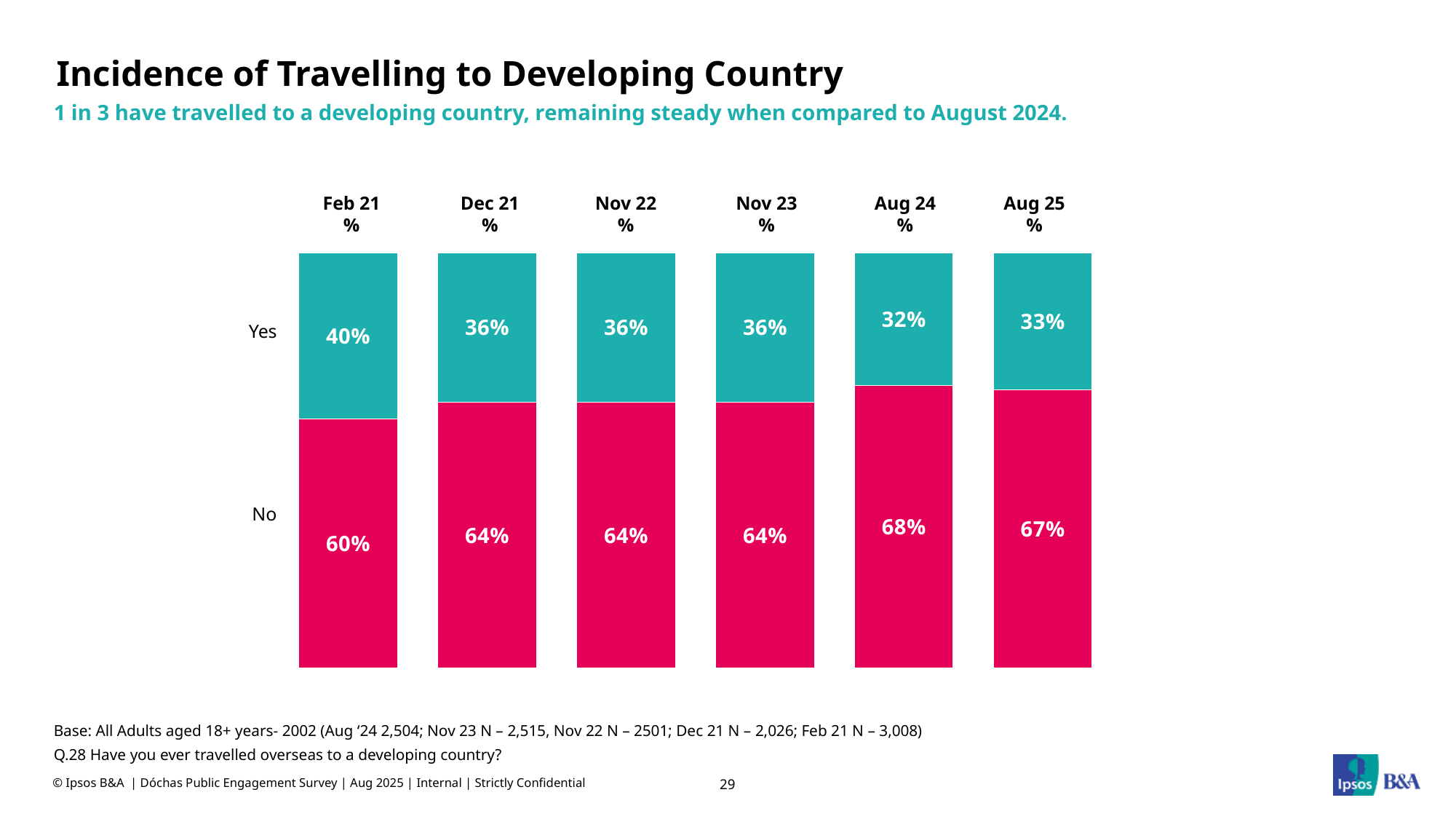
What is the total of the Yes and No segments for the Nov 22 bar? 100% What percentage answered No in Aug 25? 67% In which wave was the Yes percentage highest? Feb 21 What is the difference between the Yes percentage in Feb 21 and in Aug 25? 7% In which wave was the Yes percentage lowest? Aug 24 What percentage answered No in Nov 23? 64% How many survey waves are shown on the chart? 6 Which is larger, the No percentage in Aug 24 or in Dec 21? Aug 24 Which colour represents the No responses? Pink/red What percentage answered Yes in Feb 21? 40% What percentage answered Yes in Aug 24? 32% What kind of chart is shown on the slide? Stacked bar chart